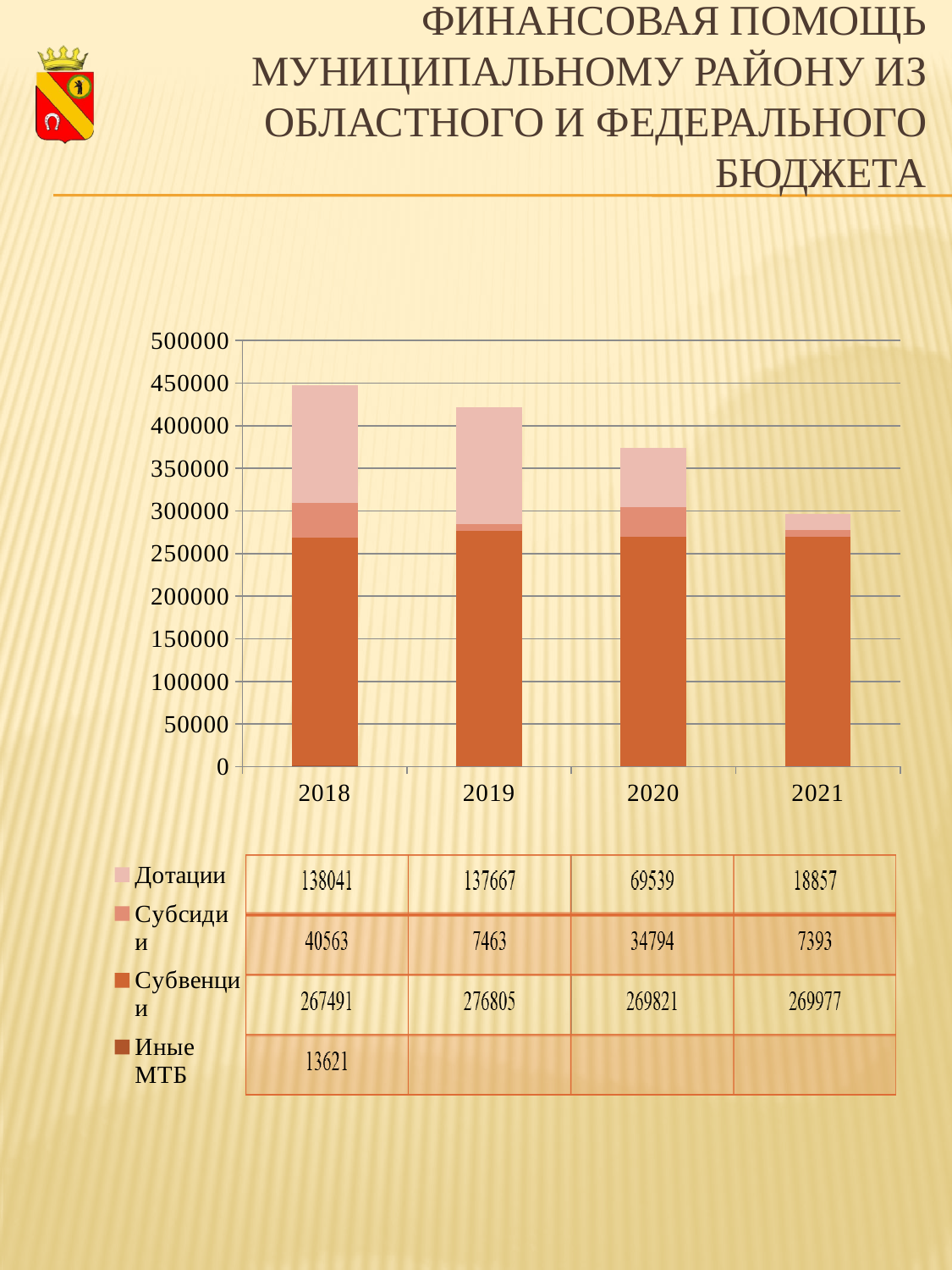
How many series does the legend list? 4 What is the total of the stacked bar for 2020 (Дотации + Субсидии + Субвенции)? 374154 What is the value of Субвенции for 2021? 269977 What is the value of Иные МТБ for 2018? 13621 How many years are shown on the x axis? 4 Which is larger: Субсидии in 2018 or Субсидии in 2019? Субсидии in 2018 Is the total height of the stacked bar for 2021 greater or less than 350000? less What is the difference between Дотации in 2018 and Дотации in 2021? 119184 What is the value of Дотации for 2018? 138041 In which year is the value of Дотации the lowest? 2021 In which year is the value of Субвенции the highest? 2019 What is the value of Субсидии for 2020? 34794